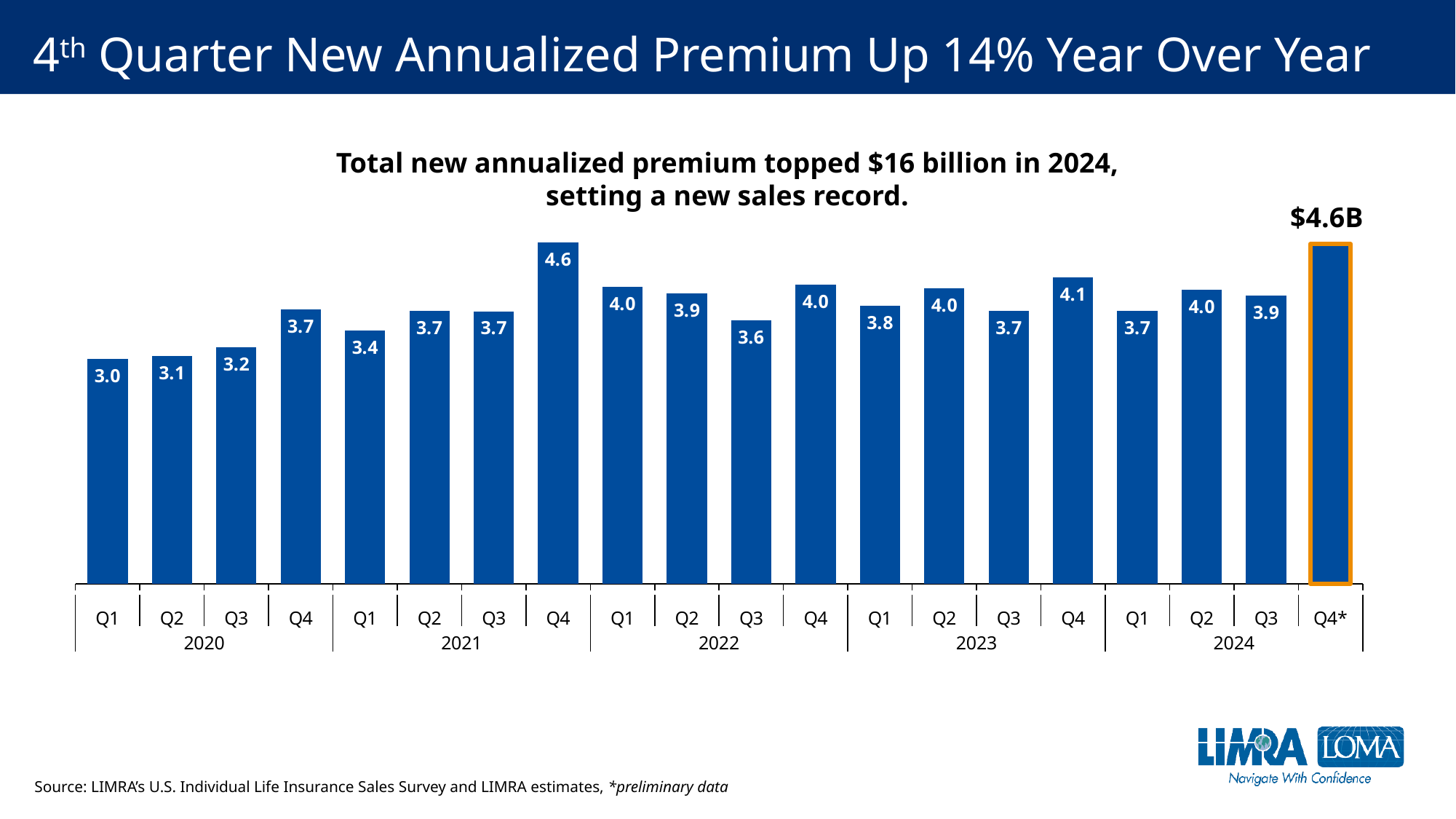
What is the difference between the values for Q4 2023 and Q4 2024? 0.5 What is the value for Q3 2022? 3.6 What is the value for Q4 2024 (Q4*)? $4.6B What kind of chart is shown on the slide? Bar chart Do the values rise or fall across the four quarters of 2020? Rise Which quarter has the lowest value on the chart? Q1 2020 Which is larger, the value for Q1 2021 or the value for Q1 2022? Q1 2022 What is the value for Q4 2023? 4.1 What is the value for Q4 2021? 4.6 How many bars are plotted on the chart? 20 What is the value for Q1 2020? 3.0 What is the difference between the values for Q4 2024 and Q3 2024? 0.7